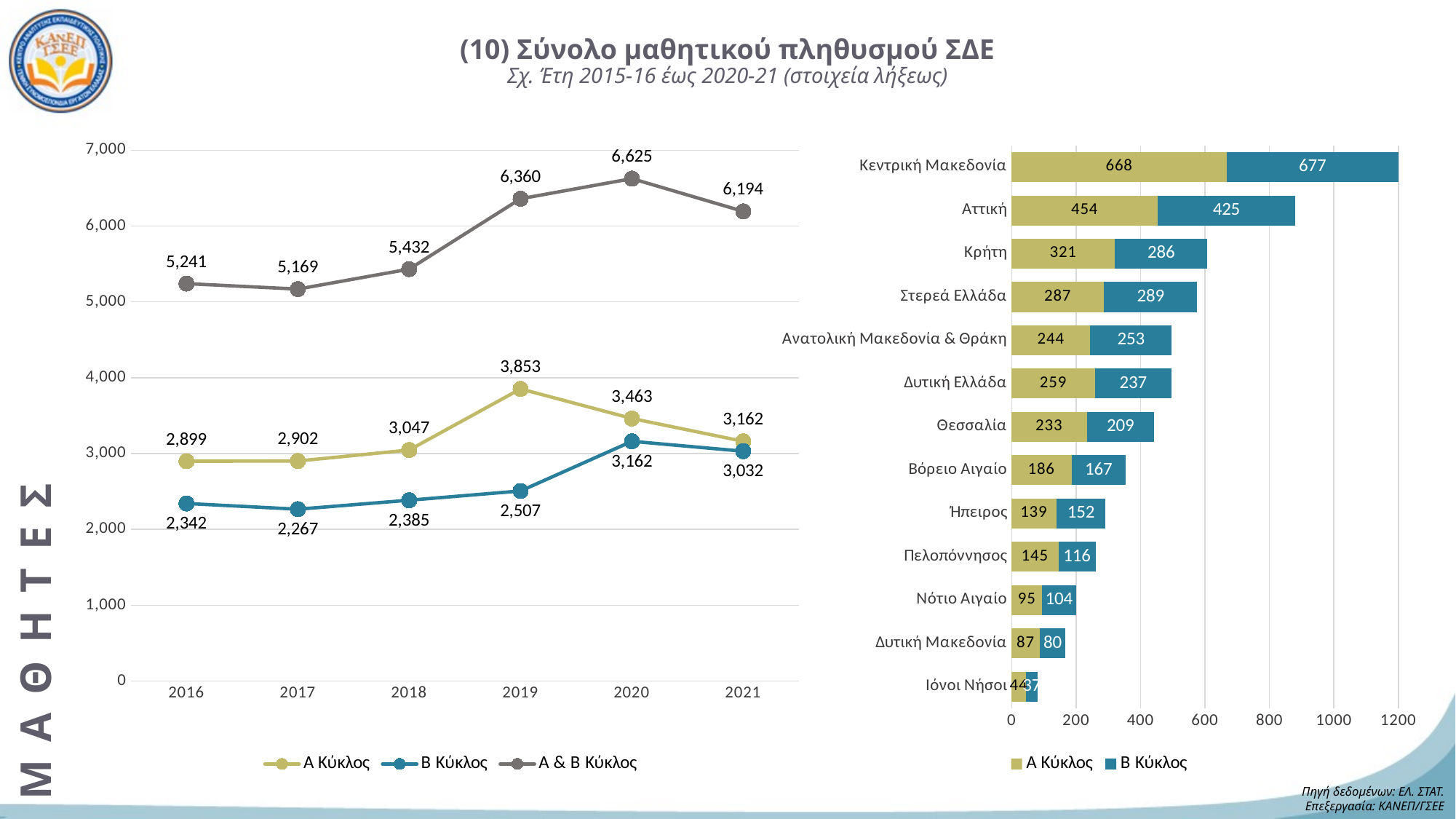
In the line chart on the left, in which year does Α Κύκλος reach its highest value? 2019 In the line chart on the left, what is the value of Β Κύκλος in 2017? 2,267 In the bar chart on the right, what is the Β Κύκλος value for Αττική? 425 In the bar chart on the right, which region has the highest Α Κύκλος value? Κεντρική Μακεδονία In the line chart on the left, what is the value of Α & Β Κύκλος in 2020? 6,625 In the line chart on the left, does Α & Β Κύκλος rise or fall from 2018 to 2019? rise In the bar chart on the right, what is the total of the stacked bar for Κρήτη? 607 What kind of chart is shown on the right side of the slide? stacked bar chart In the line chart on the left, how many series does the legend list? 3 In the line chart on the left, what is the difference between Α Κύκλος and Β Κύκλος in 2019? 1,346 In the bar chart on the right, which is larger for Θεσσαλία: Α Κύκλος or Β Κύκλος? Α Κύκλος In the line chart on the left, in which year is Α & Β Κύκλος lowest? 2017